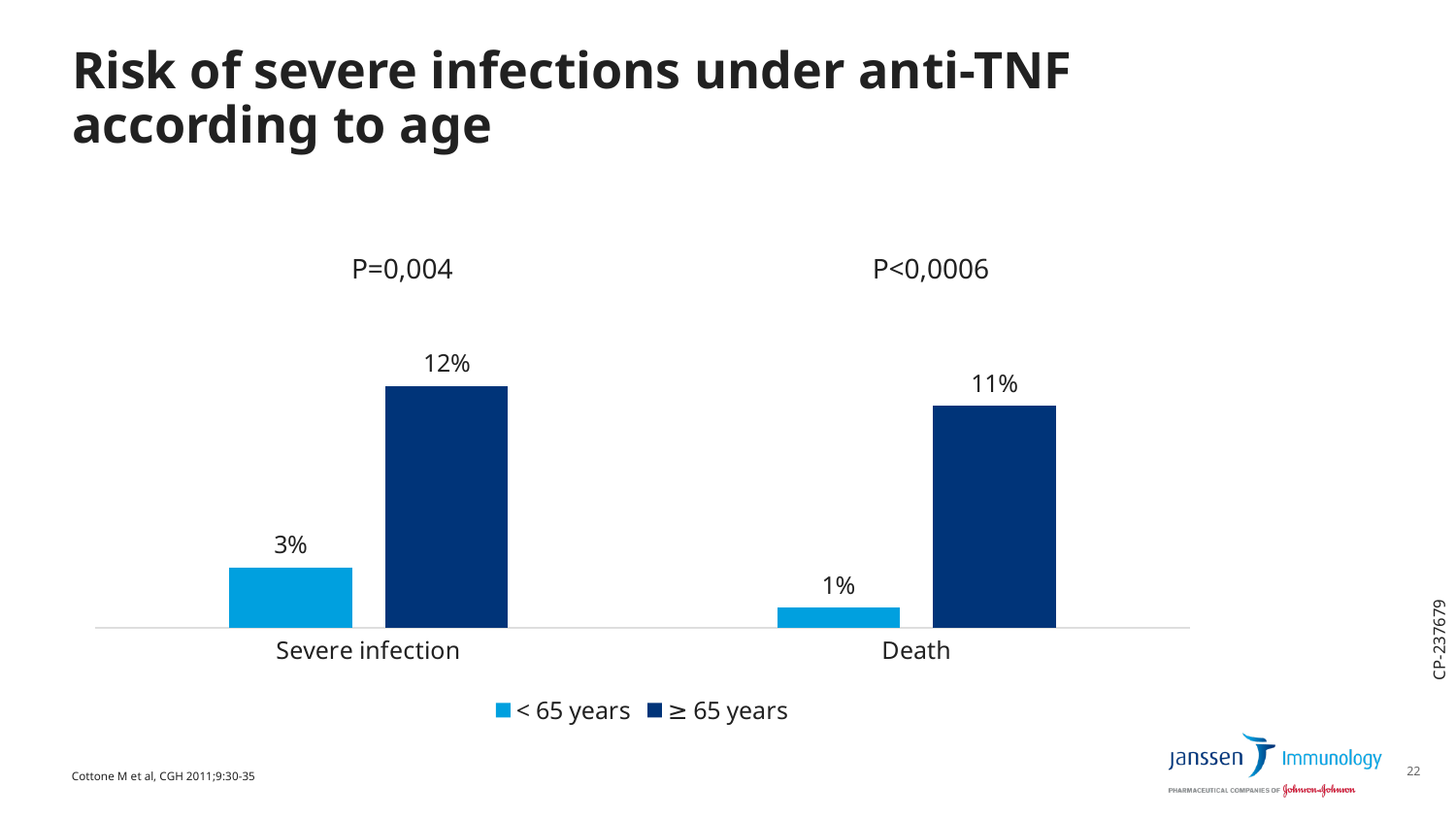
What is the difference between the ≥ 65 years and < 65 years values for Death? 10% What is the difference between the ≥ 65 years and < 65 years values for Severe infection? 9% How many categories are shown on the x axis? 2 Which bar has the lowest value on the chart? < 65 years, Death What kind of chart is shown on the slide? Bar chart How many series does the legend list? 2 What is the value for ≥ 65 years in the Severe infection category? 12% Which bar has the highest value on the chart? ≥ 65 years, Severe infection What is the value for ≥ 65 years in the Death category? 11% What is the value for < 65 years in the Death category? 1% Which is larger for Death: the < 65 years value or the ≥ 65 years value? ≥ 65 years What is the value for < 65 years in the Severe infection category? 3%